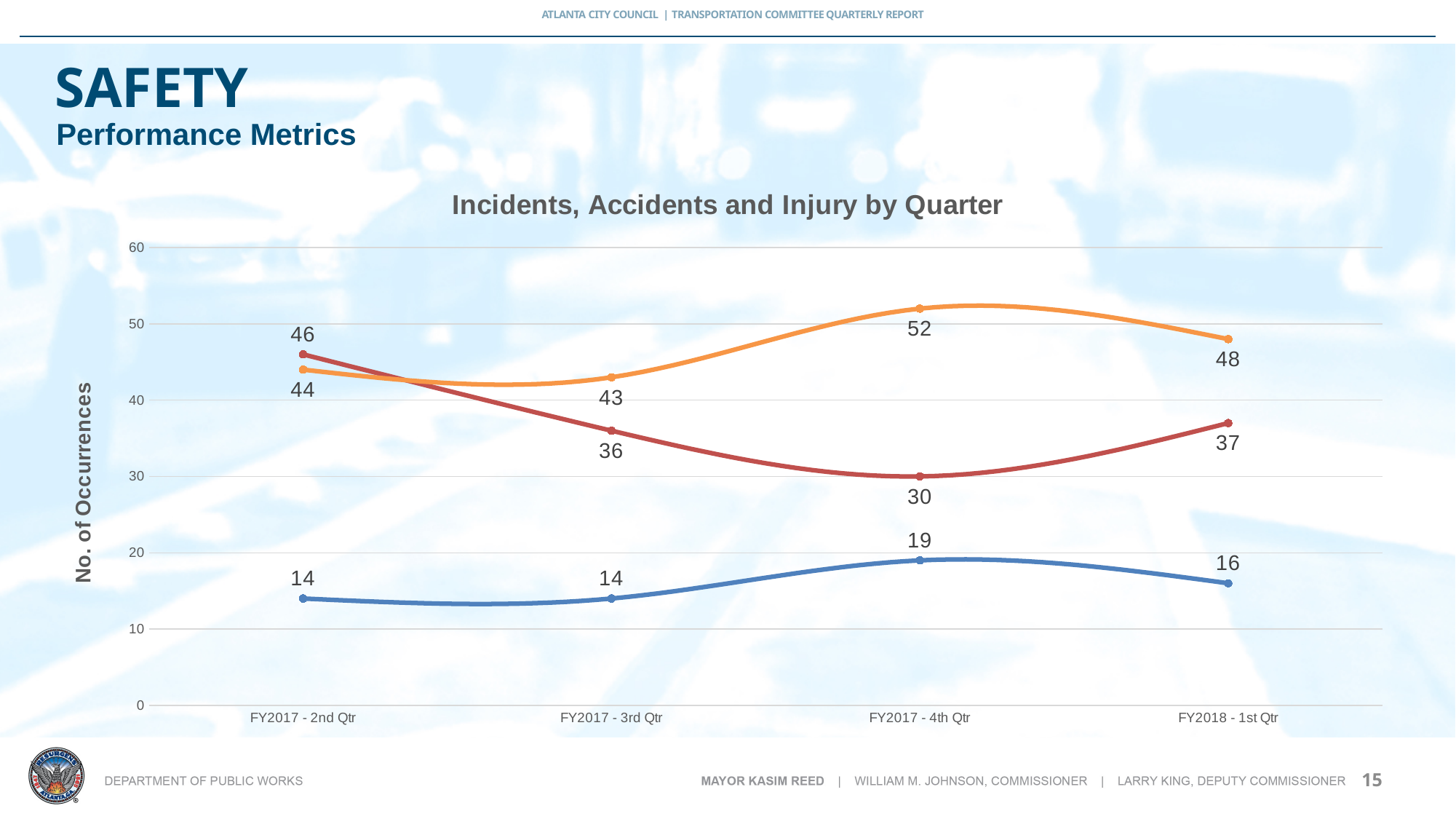
How many lines are plotted on the chart? 3 Does the red line rise or fall from FY2017 - 2nd Qtr to FY2017 - 4th Qtr? Fall At FY2017 - 2nd Qtr, which line has the higher value, the red line or the orange line? Red line How many quarters are shown on the x axis of the chart? 4 What is the title of the chart? Incidents, Accidents and Injury by Quarter What is the value of the red line at FY2017 - 3rd Qtr? 36 What is the difference between the orange line and the red line at FY2018 - 1st Qtr? 11 What is the value of the blue line at FY2018 - 1st Qtr? 16 What type of chart is shown on the slide? Line chart At which quarter does the red line reach its lowest value? FY2017 - 4th Qtr What is the value of the orange line at FY2017 - 4th Qtr? 52 At which quarter does the orange line reach its highest value? FY2017 - 4th Qtr